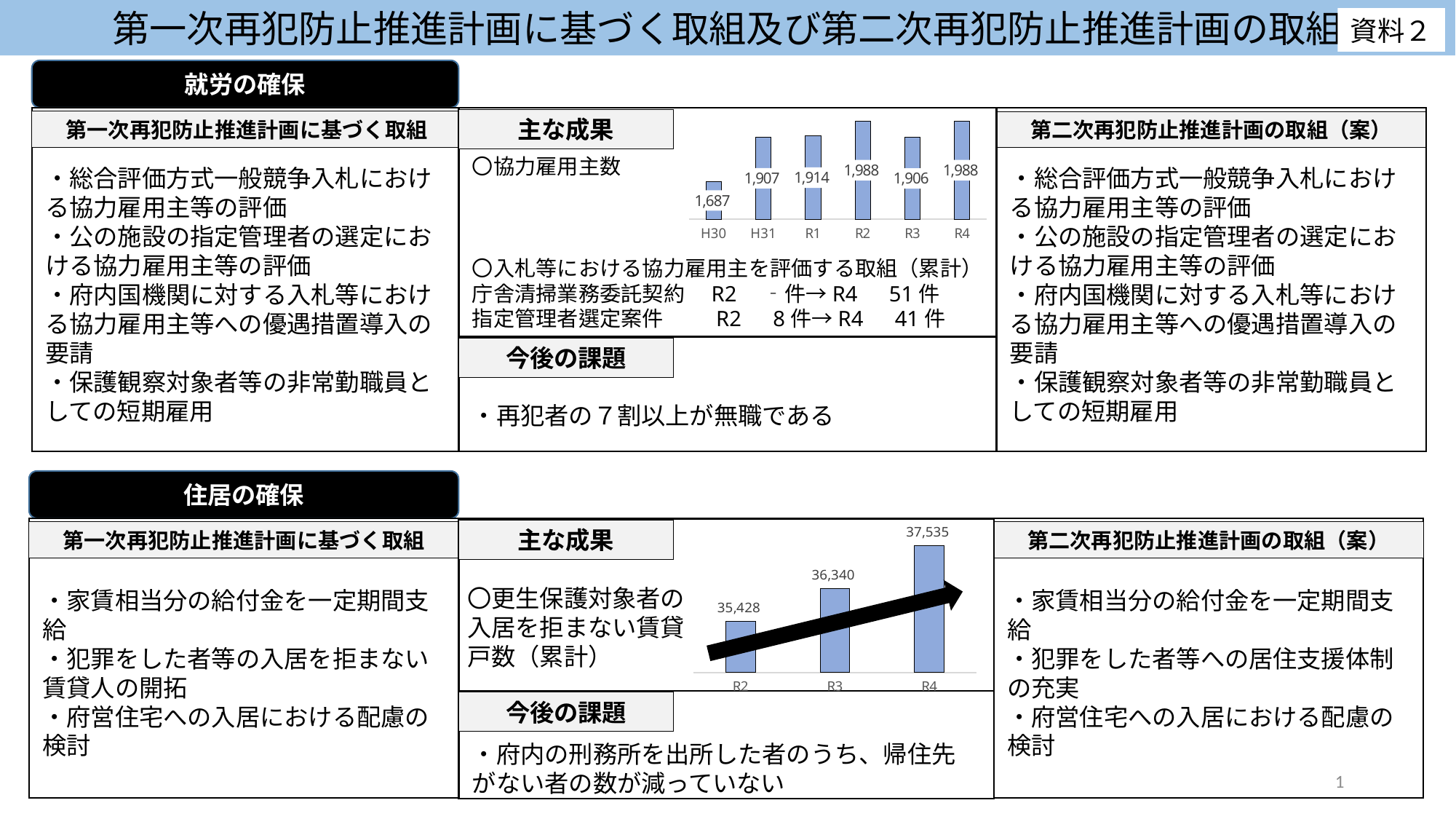
In the top chart (協力雇用主数), how many categories are shown on the x axis? 6 In the bottom chart (更生保護対象者の入居を拒まない賃貸戸数（累計）), do the values rise or fall from R2 to R4? rise In the bottom chart (更生保護対象者の入居を拒まない賃貸戸数（累計）), how many bars are shown? 3 In the top chart (協力雇用主数), what is the difference between the values for R2 and H30? 301 In the top chart (協力雇用主数), is the value for R4 larger or smaller than the value for R3? larger In the top chart (協力雇用主数), which category has the lowest value? H30 What kind of chart is the top chart (協力雇用主数)? bar chart In the top chart (協力雇用主数), what is the value for R3? 1,906 In the bottom chart (更生保護対象者の入居を拒まない賃貸戸数（累計）), which category has the highest value? R4 In the top chart (協力雇用主数), what is the value for H30? 1,687 In the bottom chart (更生保護対象者の入居を拒まない賃貸戸数（累計）), what is the value for R3? 36,340 In the bottom chart (更生保護対象者の入居を拒まない賃貸戸数（累計）), what is the difference between the values for R4 and R2? 2,107